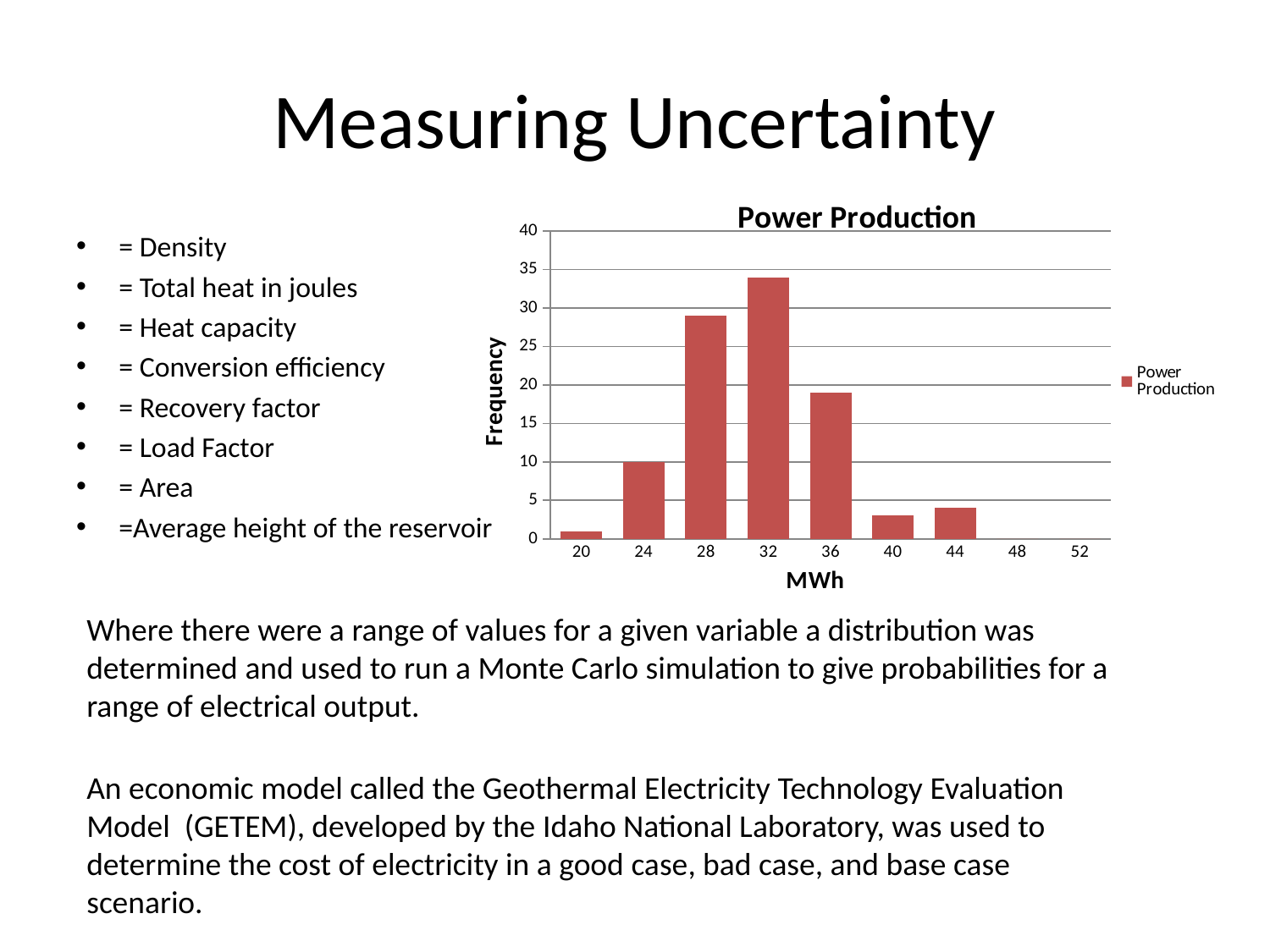
Do the frequencies rise or fall from 32 MWh to 40 MWh? fall Which MWh category has the highest frequency? 32 Which has the higher frequency, 28 MWh or 36 MWh? 28 Is the frequency for 40 MWh greater or less than 5? less Is the frequency for 28 MWh greater or less than 25? greater How many series does the legend list? 1 What kind of chart is shown on the slide? bar chart How many MWh categories are shown on the x axis? 9 Is the frequency for 36 MWh greater or less than 25? less What is the title of the chart? Power Production What is the label on the x axis of the chart? MWh